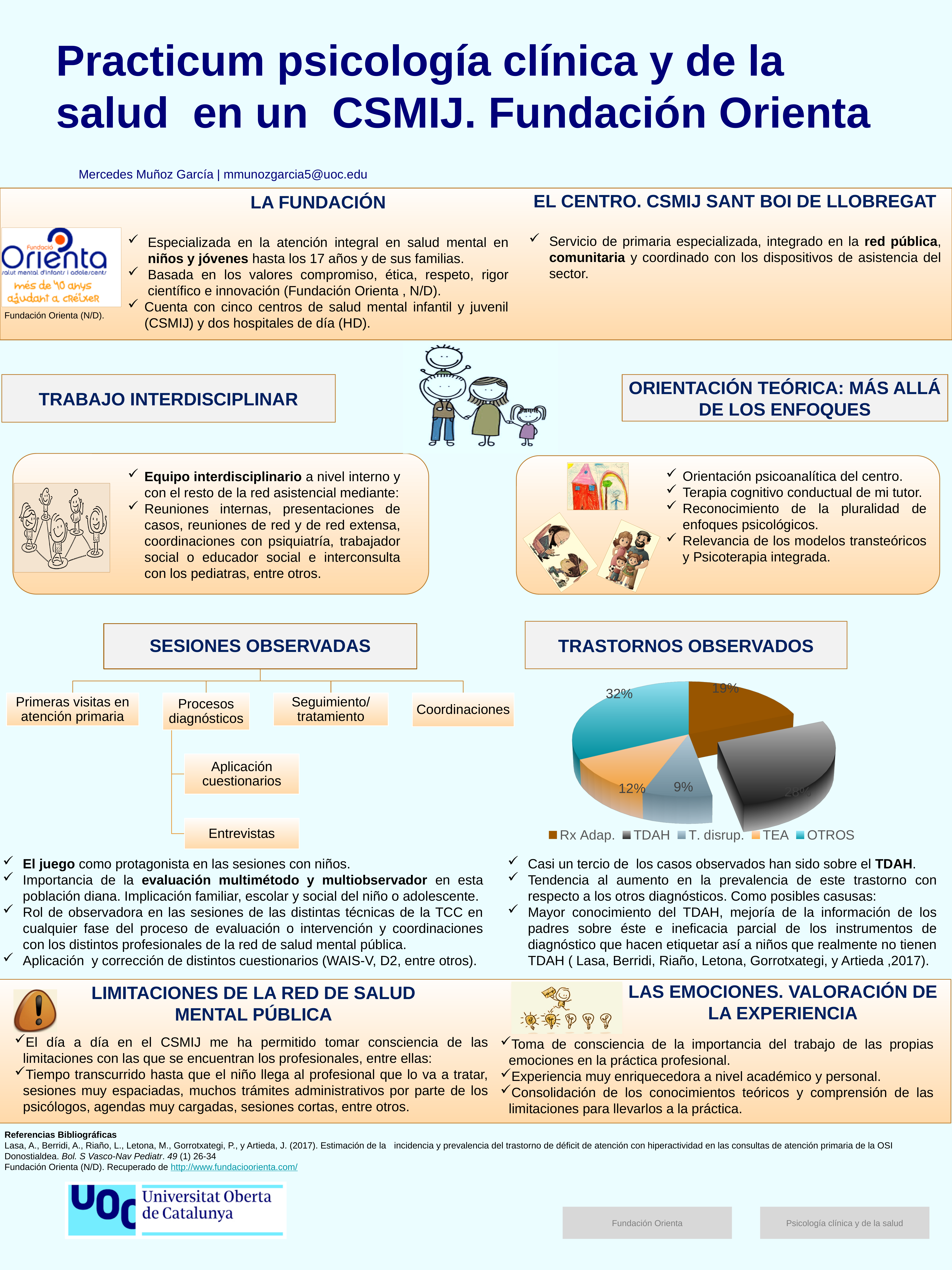
What kind of chart is shown under the heading TRASTORNOS OBSERVADOS? pie chart In the TRASTORNOS OBSERVADOS pie chart, what percentage is shown for T. disrup.? 9% How many categories does the legend of the TRASTORNOS OBSERVADOS pie chart list? 5 In the TRASTORNOS OBSERVADOS pie chart, which slice is larger, TDAH or Rx Adap.? TDAH In the TRASTORNOS OBSERVADOS pie chart, what is the difference in percentage points between Rx Adap. and TEA? 7 In the TRASTORNOS OBSERVADOS pie chart, what is the difference in percentage points between OTROS and TEA? 20 In the TRASTORNOS OBSERVADOS pie chart, which slice is larger, TEA or T. disrup.? TEA In the TRASTORNOS OBSERVADOS pie chart, what percentage is shown for TEA? 12% In the TRASTORNOS OBSERVADOS pie chart, which category has the largest slice? OTROS In the TRASTORNOS OBSERVADOS pie chart, what percentage is shown for Rx Adap.? 19% In the TRASTORNOS OBSERVADOS pie chart, what percentage is shown for OTROS? 32% In the TRASTORNOS OBSERVADOS pie chart, which category has the smallest slice? T. disrup.